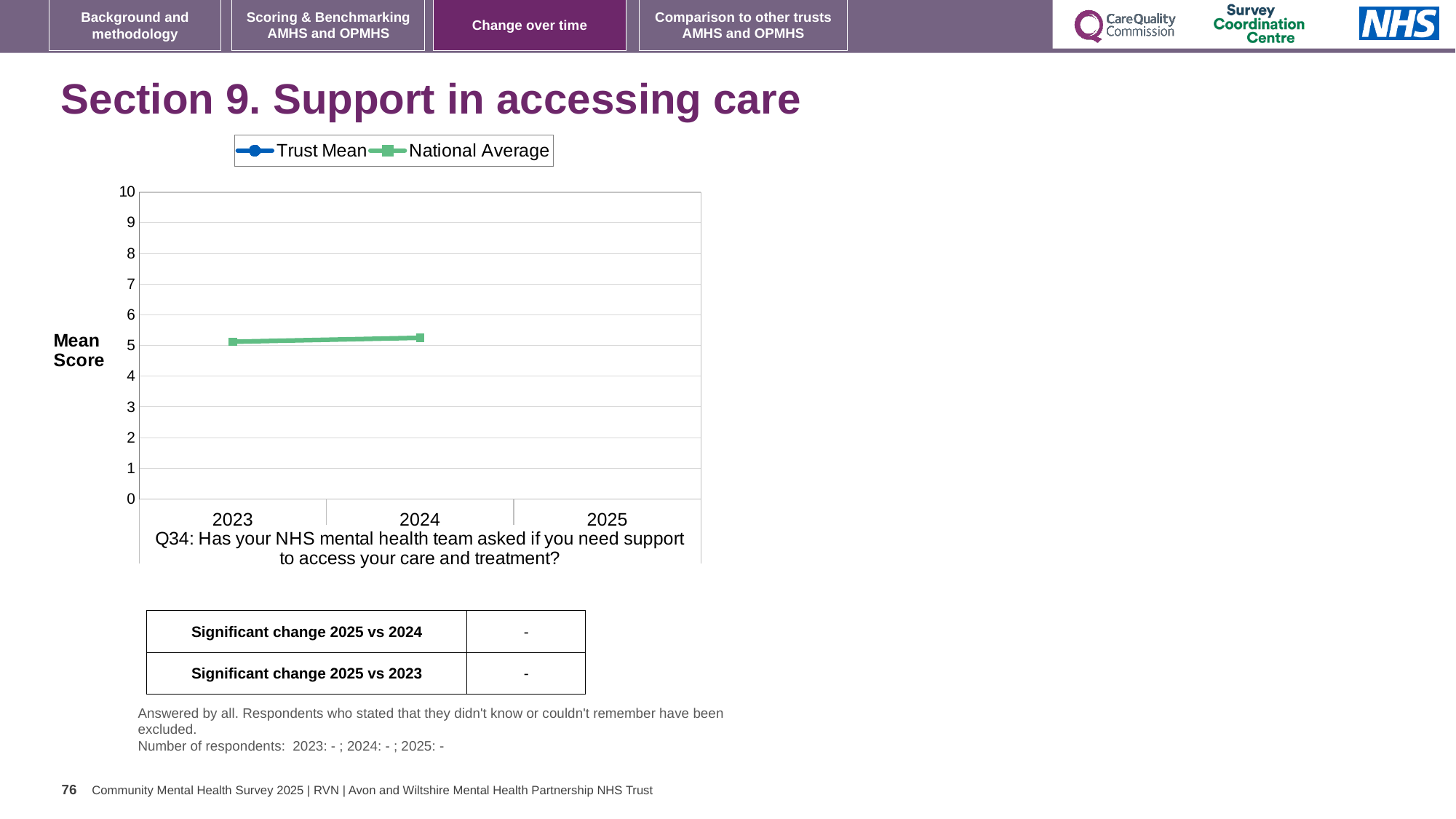
Is the National Average value for 2023 greater or less than 6? less For which year on the x axis is no National Average point plotted? 2025 Is the National Average value for 2024 greater or less than 4? greater Is the National Average value for 2024 greater or less than 7? less What is the highest value shown on the chart's vertical axis? 10 How many series does the chart legend list? 2 What kind of chart is shown on the slide? line chart What is the label on the vertical axis of the chart? Mean Score Which two series are listed in the chart legend? Trust Mean and National Average How many years are shown on the x axis of the chart? 3 Does the National Average line rise or fall from 2023 to 2024? rise Which year has the higher National Average value, 2023 or 2024? 2024